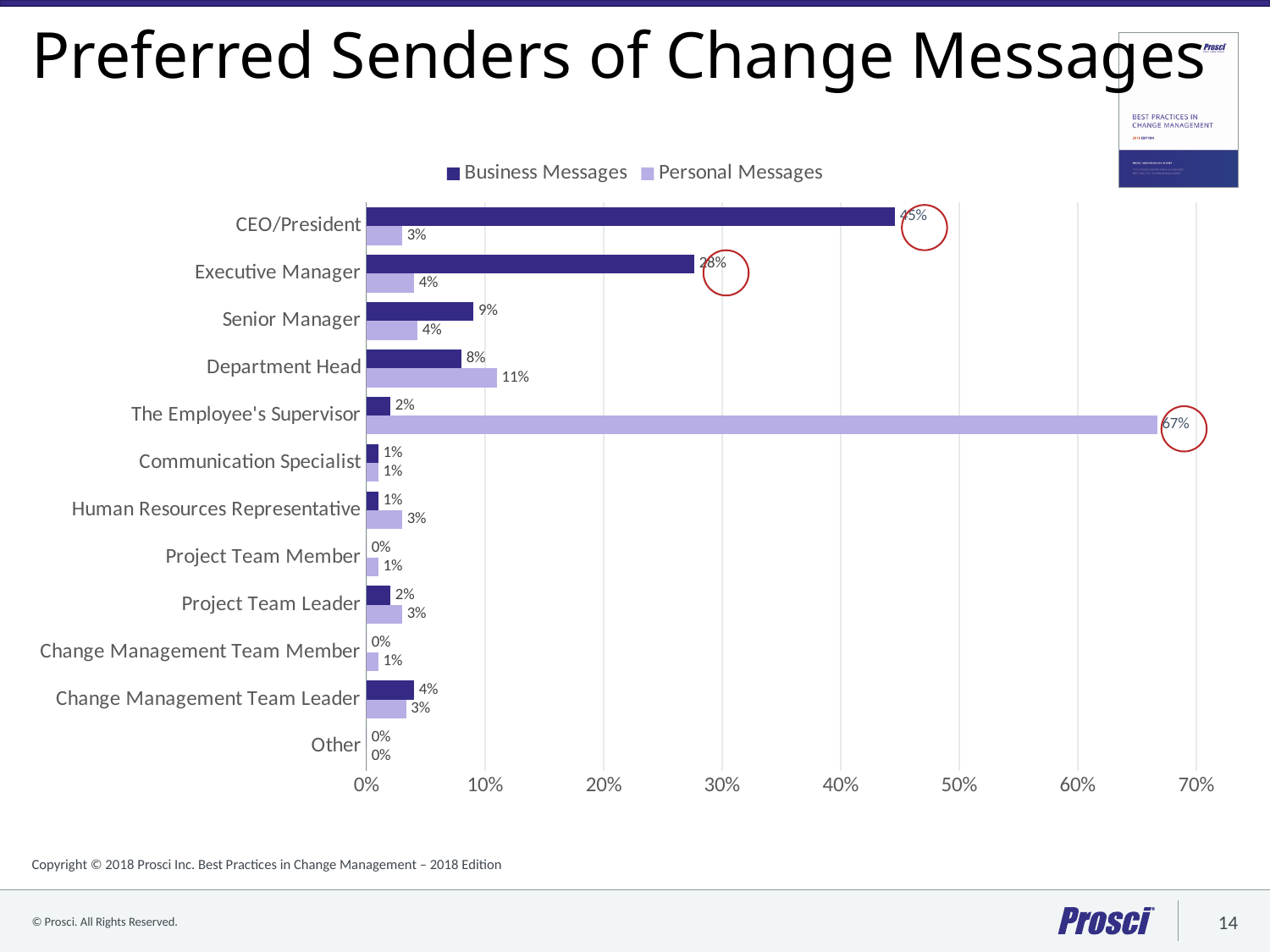
What is the Personal Messages value for Department Head? 11% Which category has the highest Personal Messages value? The Employee's Supervisor Is the Business Messages value for Executive Manager greater or less than 20%? greater What type of chart is shown on the slide? Bar chart Which category has the highest Business Messages value? CEO/President How many series does the legend list? 2 What is the Business Messages value for Senior Manager? 9% For Senior Manager, which is larger: Business Messages or Personal Messages? Business Messages For Department Head, how much higher is the Personal Messages value than the Business Messages value? 3 percentage points Is the Business Messages value for CEO/President greater or less than 40%? greater How many sender categories are plotted on the chart? 12 What is the Personal Messages value for The Employee's Supervisor? 67%